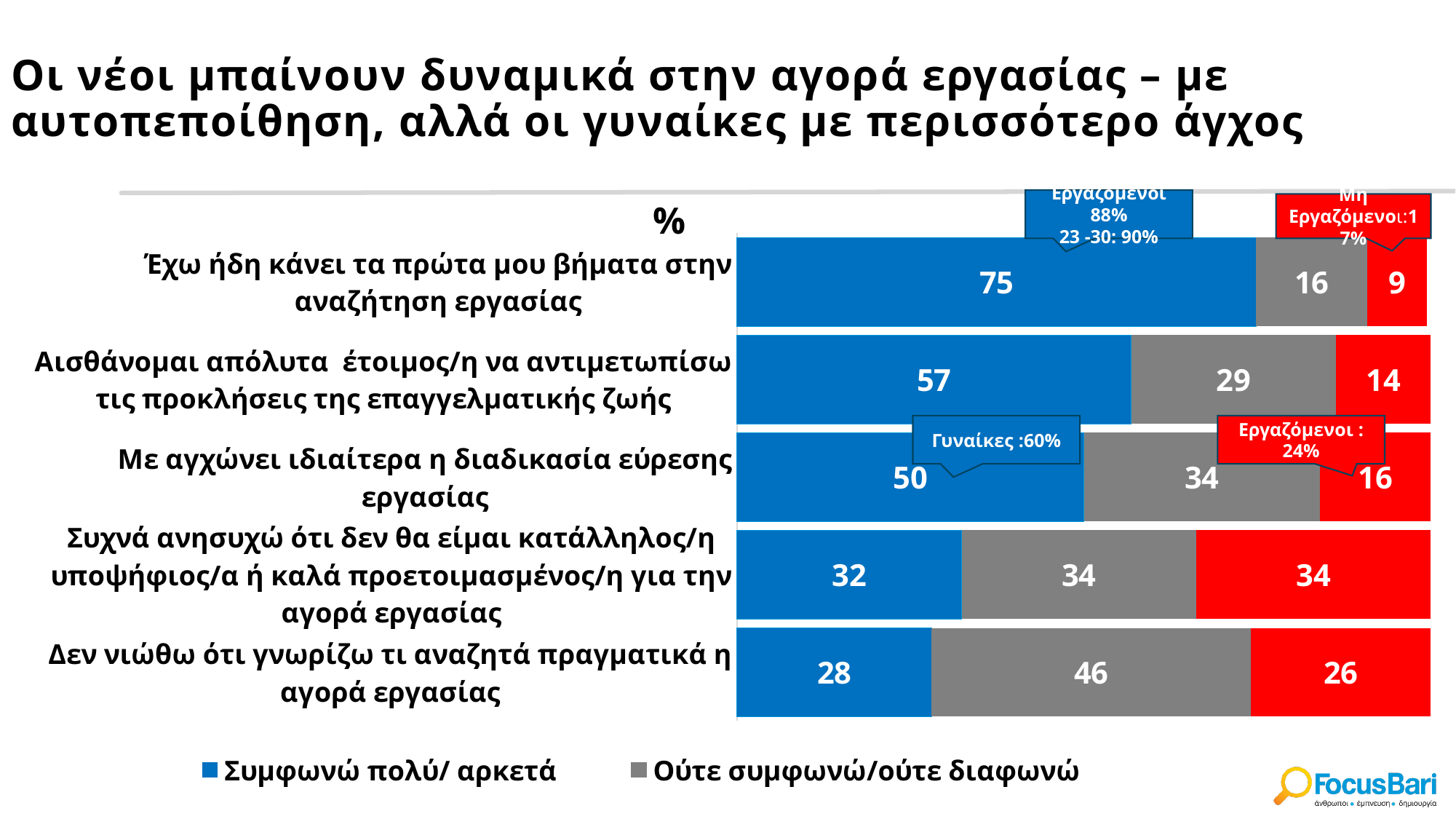
How many statements (categories) are plotted in the chart? 5 What is the 'Συμφωνώ πολύ/ αρκετά' value for 'Έχω ήδη κάνει τα πρώτα μου βήματα στην αναζήτηση εργασίας'? 75 Which statement has the highest 'Συμφωνώ πολύ/ αρκετά' value? Έχω ήδη κάνει τα πρώτα μου βήματα στην αναζήτηση εργασίας What percentage of women ('Γυναίκες') is shown in the callout for 'Με αγχώνει ιδιαίτερα η διαδικασία εύρεσης εργασίας'? 60% What is the 'Ούτε συμφωνώ/ούτε διαφωνώ' value for 'Αισθάνομαι απόλυτα έτοιμος/η να αντιμετωπίσω τις προκλήσεις της επαγγελματικής ζωής'? 29 What kind of chart is shown on the slide? stacked bar chart Which statement has the lowest 'Συμφωνώ πολύ/ αρκετά' value? Δεν νιώθω ότι γνωρίζω τι αναζητά πραγματικά η αγορά εργασίας Which colour represents 'Συμφωνώ πολύ/ αρκετά' in the chart? blue What is the total of the stacked bar for 'Με αγχώνει ιδιαίτερα η διαδικασία εύρεσης εργασίας'? 100 Which is larger: the 'Ούτε συμφωνώ/ούτε διαφωνώ' value for 'Δεν νιώθω ότι γνωρίζω τι αναζητά πραγματικά η αγορά εργασίας' or for 'Με αγχώνει ιδιαίτερα η διαδικασία εύρεσης εργασίας'? Δεν νιώθω ότι γνωρίζω τι αναζητά πραγματικά η αγορά εργασίας What is the red segment value for 'Δεν νιώθω ότι γνωρίζω τι αναζητά πραγματικά η αγορά εργασίας'? 26 What is the difference between the 'Συμφωνώ πολύ/ αρκετά' values for 'Έχω ήδη κάνει τα πρώτα μου βήματα στην αναζήτηση εργασίας' and 'Αισθάνομαι απόλυτα έτοιμος/η να αντιμετωπίσω τις προκλήσεις της επαγγελματικής ζωής'? 18